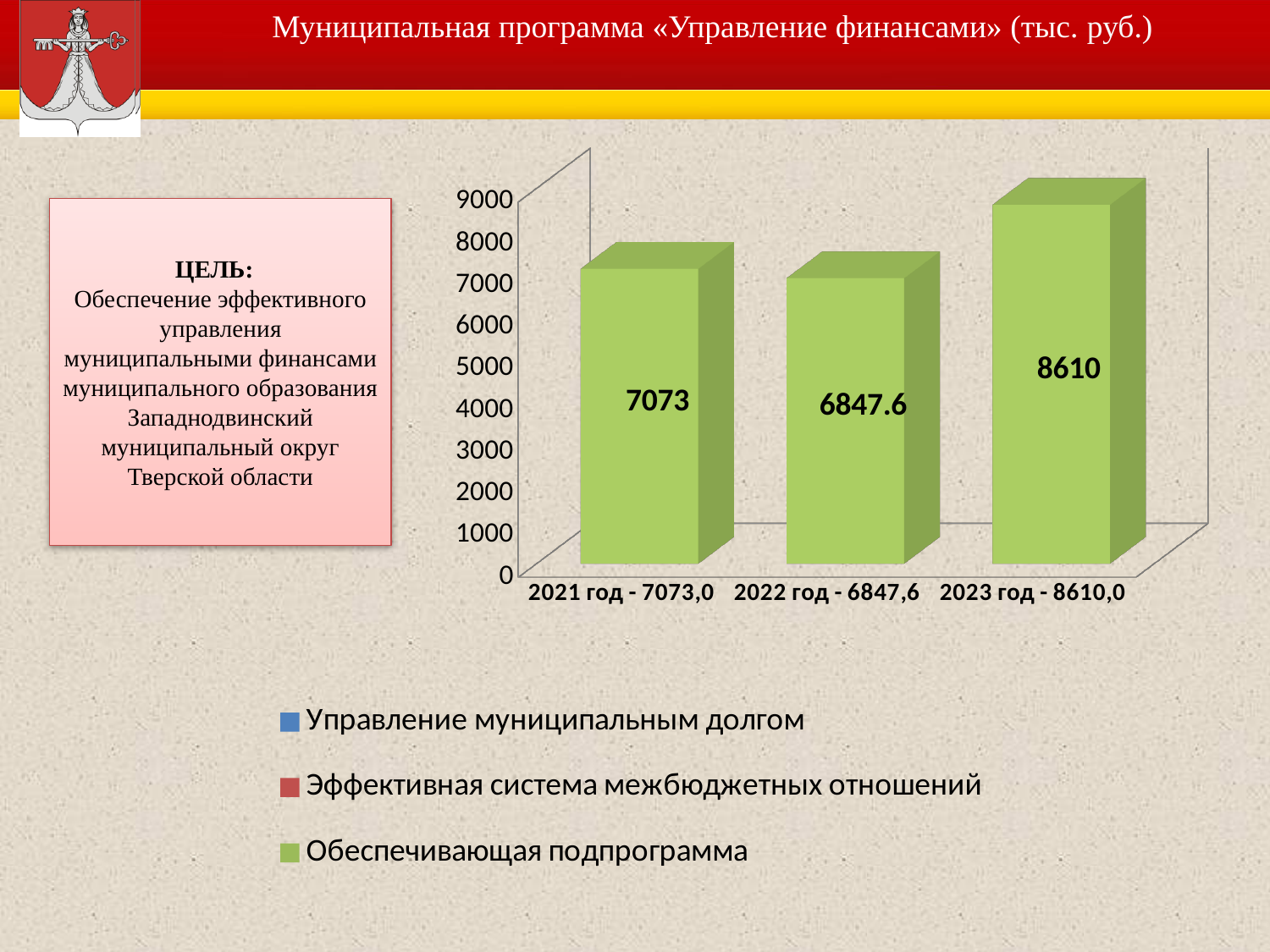
How many series does the legend list? 3 What value is shown on the bar for 2023 год? 8610 Which year has the lowest bar? 2022 год Which is larger, the value for 2021 год or the value for 2022 год? 2021 год Which year has the highest bar? 2023 год How many bars are plotted in the chart? 3 Is the value for 2023 год greater or less than 8000? greater What is the difference between the values for 2023 год and 2021 год? 1537 What kind of chart is shown on the slide? bar chart What is the difference between the values for 2021 год and 2022 год? 225.4 What value is shown on the bar for 2022 год? 6847.6 What value is shown on the bar for 2021 год? 7073